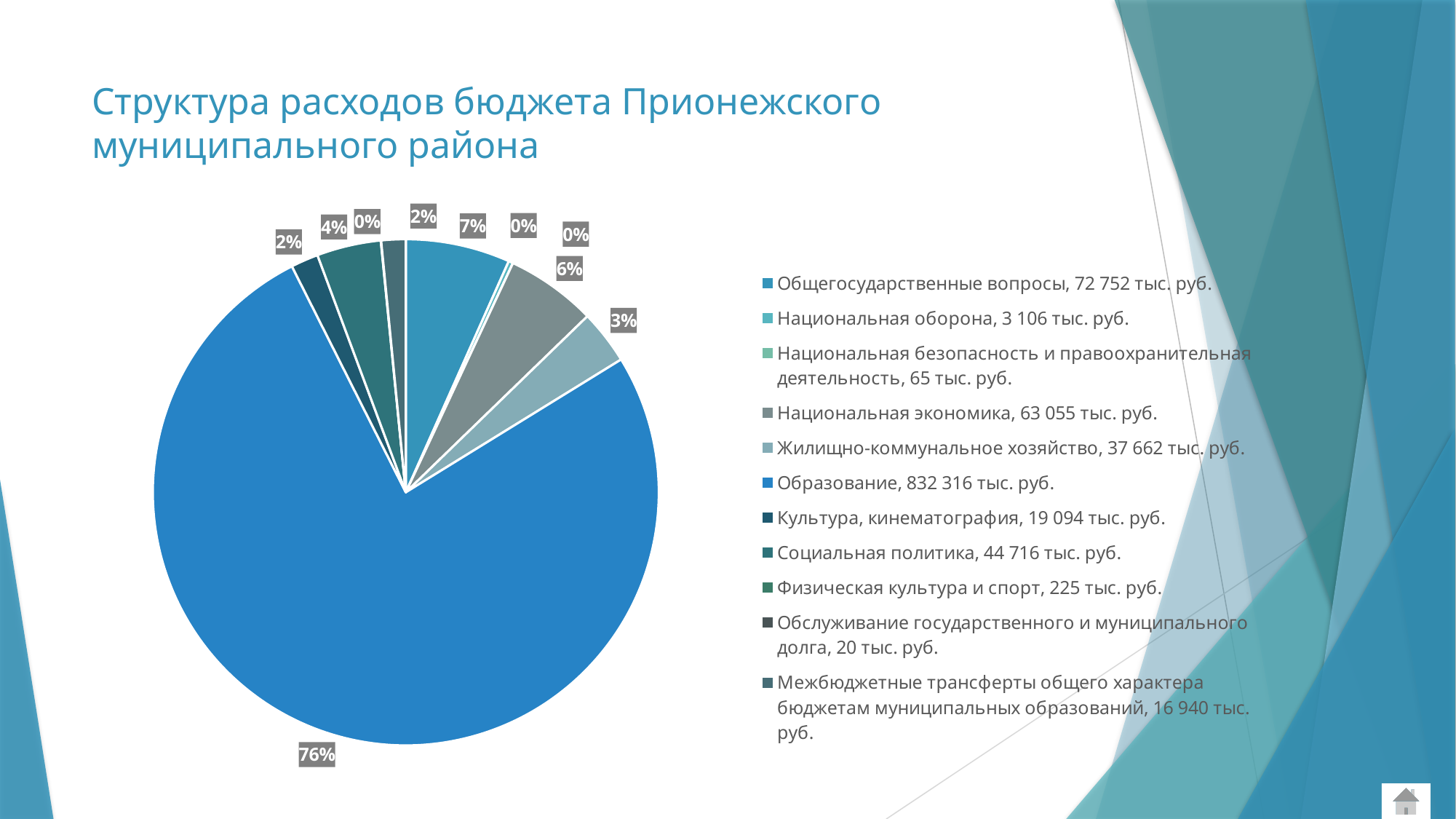
What is the value for Жилищно-коммунальное хозяйство according to the legend? 37 662 тыс. руб. What is the value for Общегосударственные вопросы according to the legend? 72 752 тыс. руб. What is the value for Образование according to the legend? 832 316 тыс. руб. How many categories does the pie chart have? 11 How many entries does the legend list? 11 What kind of chart is shown on the slide? pie chart What is the difference between the values for Общегосударственные вопросы and Национальная экономика? 9 697 тыс. руб. Which is larger, Национальная экономика or Социальная политика? Национальная экономика What share of the pie does Национальная экономика take? 6% Which category has the smallest value in the legend? Обслуживание государственного и муниципального долга Which category has the largest share of the pie? Образование What share of the pie does Образование take? 76%